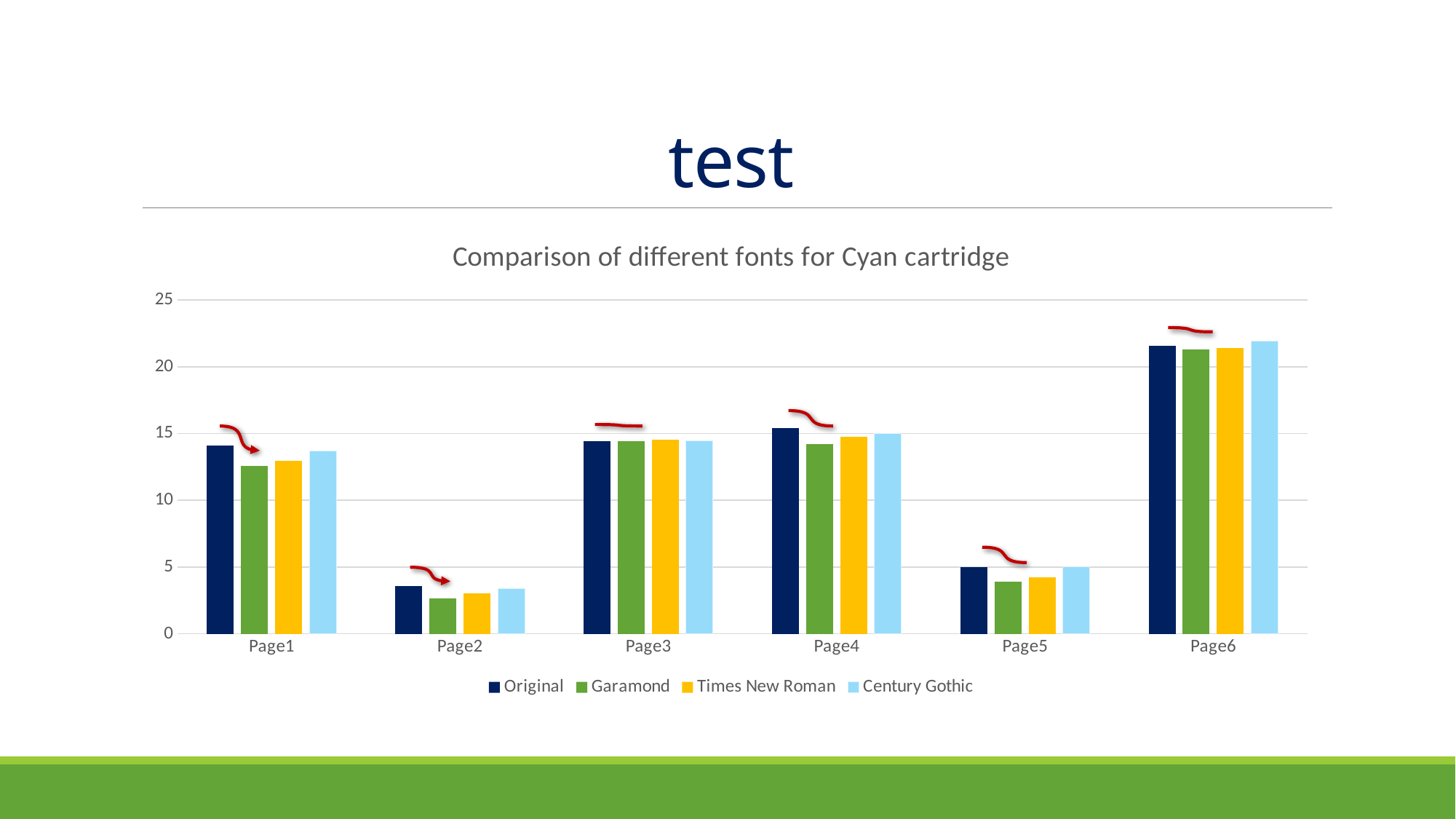
How many series does the legend list? 4 Is the value for Garamond at Page1 greater or less than 10? greater At Page1, which is larger: Original or Garamond? Original Which page has the highest value for the Original series? Page6 Is the value for Original at Page6 greater or less than 20? greater Is the value for Original at Page1 greater or less than 15? less How many page categories are shown on the x axis? 6 At Page4, which is larger: Original or Garamond? Original What is the title of the chart? Comparison of different fonts for Cyan cartridge Which page has the lowest value for the Garamond series? Page2 What kind of chart is shown on the slide? bar chart